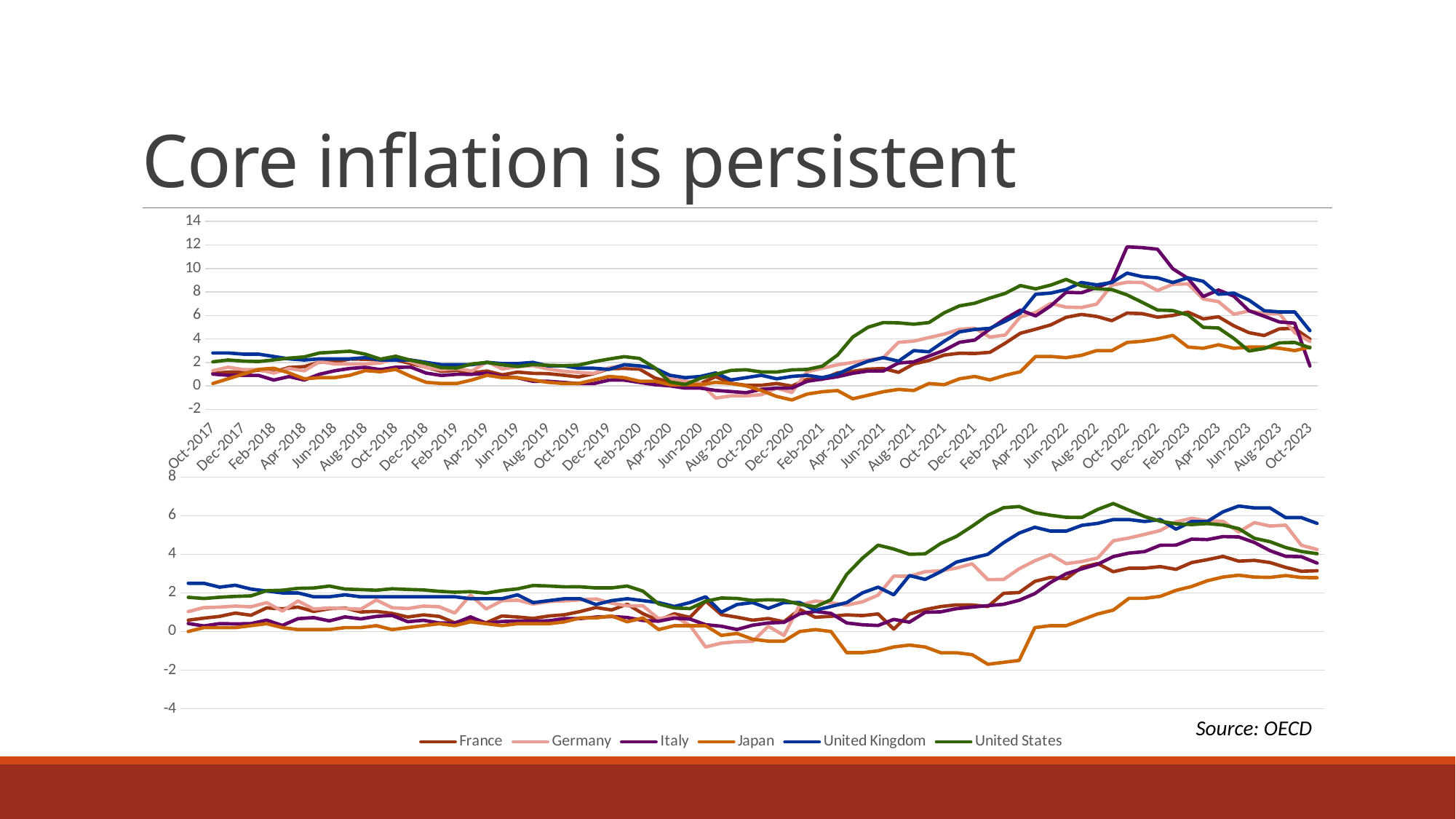
What kind of chart is the top chart on the slide? Line chart In the top chart, is the value for Italy at Dec-2022 greater or less than 10? greater In the bottom chart, which country's line reaches the lowest point? Japan In the top chart, is the value for the United States at Jun-2022 greater or less than 8? greater In the top chart, which is larger at Dec-2022: the value for Italy or the value for Japan? Italy In the top chart, does the United States line rise or fall between Oct-2022 and Aug-2023? Falls In the top chart, is the value for Japan at Oct-2023 greater or less than 4? less What is the source cited for the charts? OECD In the top chart, does the Italy line rise or fall between Jun-2021 and Oct-2022? Rises How many series does the legend list? 6 In the top chart, which country's line reaches the highest peak? Italy